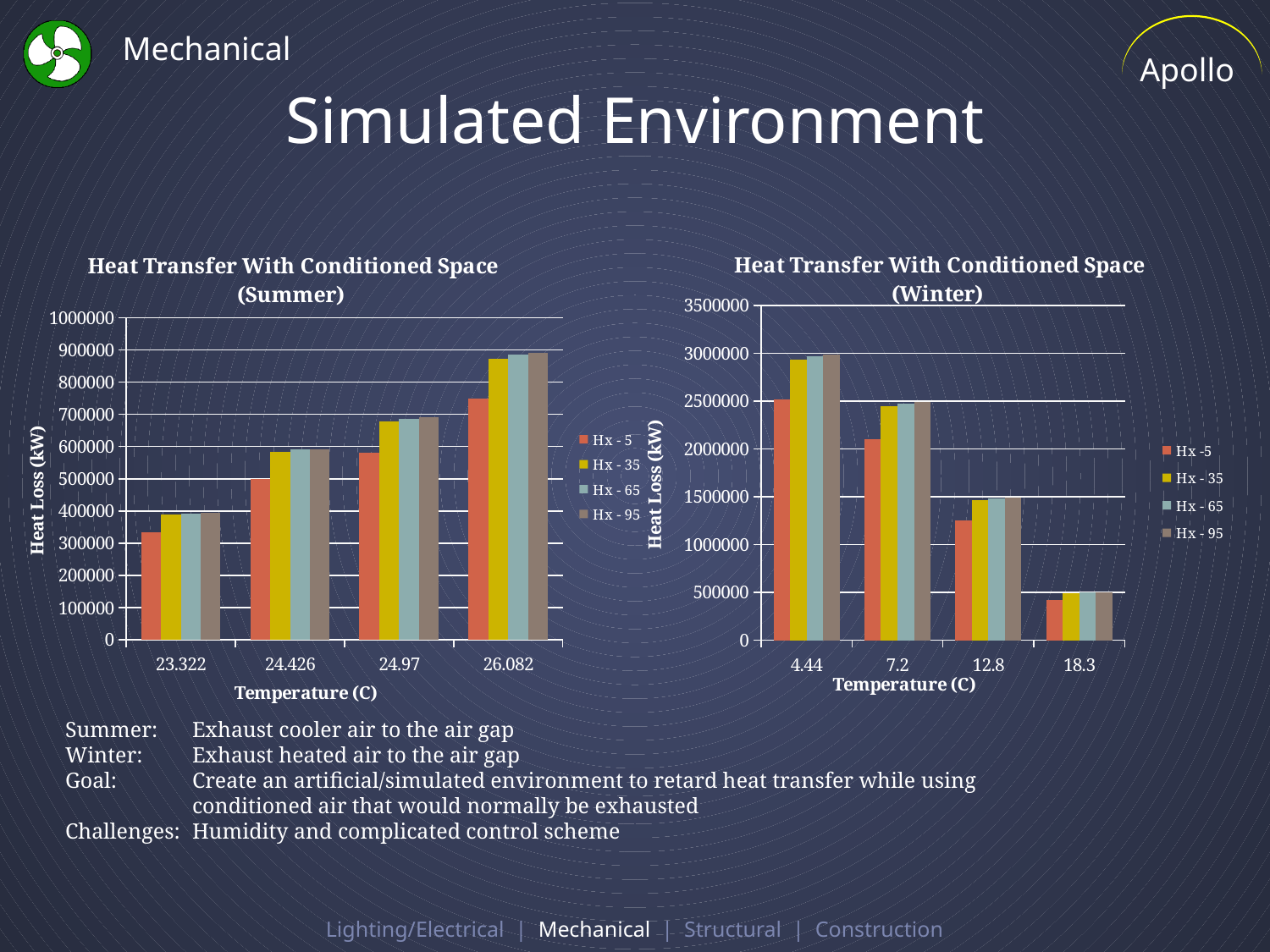
In the 'Heat Transfer With Conditioned Space (Summer)' chart, is the Hx - 35 value at 26.082 greater or less than 800000? greater In the 'Heat Transfer With Conditioned Space (Winter)' chart, do the heat loss values rise or fall as temperature increases along the x axis? fall How many temperature categories are shown on the x axis of the 'Heat Transfer With Conditioned Space (Summer)' chart? 4 In the 'Heat Transfer With Conditioned Space (Winter)' chart, is the Hx - 35 value at 4.44 greater or less than 2500000? greater What kind of chart is the 'Heat Transfer With Conditioned Space (Summer)' chart? bar chart In the 'Heat Transfer With Conditioned Space (Winter)' chart, is the Hx - 5 value at 18.3 greater or less than 500000? less In the 'Heat Transfer With Conditioned Space (Summer)' chart, do the heat loss values rise or fall as temperature increases along the x axis? rise How many series does the legend of the 'Heat Transfer With Conditioned Space (Winter)' chart list? 4 In the 'Heat Transfer With Conditioned Space (Summer)' chart, at 23.322, which is larger: Hx - 5 or Hx - 35? Hx - 35 In the 'Heat Transfer With Conditioned Space (Summer)' chart, at which temperature is the Hx - 95 heat loss lowest? 23.322 In the 'Heat Transfer With Conditioned Space (Winter)' chart, at which temperature is the Hx - 5 heat loss highest? 4.44